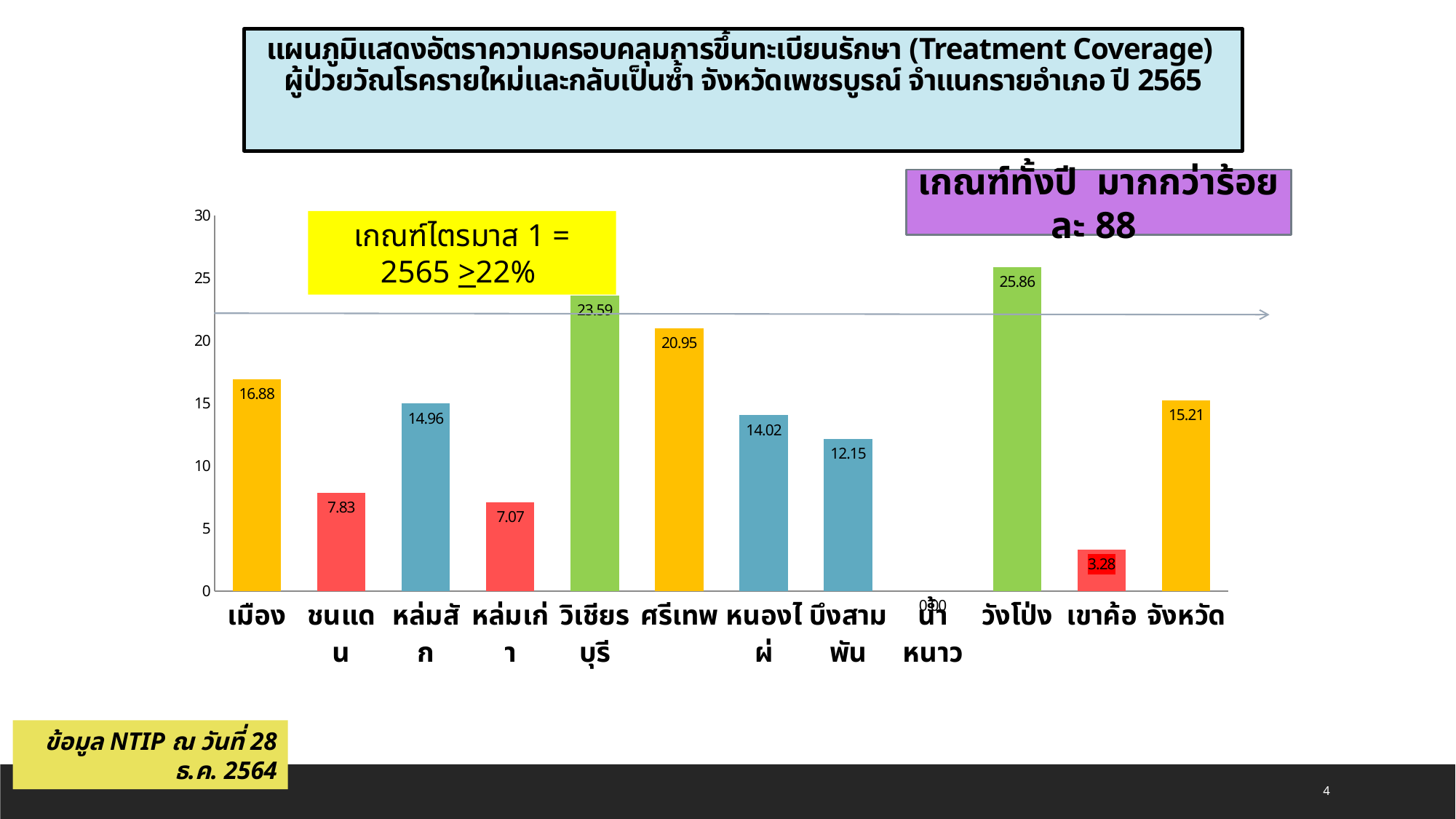
What is the value for เขาค้อ? 3.28 According to the yellow box, what is the criterion for quarter 1 of 2565? ≥22% Which is larger, the value for เมือง or the value for หล่มสัก? เมือง What is the difference between the values for วิเชียรบุรี and ศรีเทพ? 2.64 Which category has the lowest value? น้ำหนาว What kind of chart is shown on the slide? bar chart How many categories are shown on the x axis? 12 What is the value for ศรีเทพ? 20.95 What is the value for วังโป่ง? 25.86 What is the value for จังหวัด? 15.21 Is the value for บึงสามพัน greater or less than 10? greater Which district has the highest value? วังโป่ง